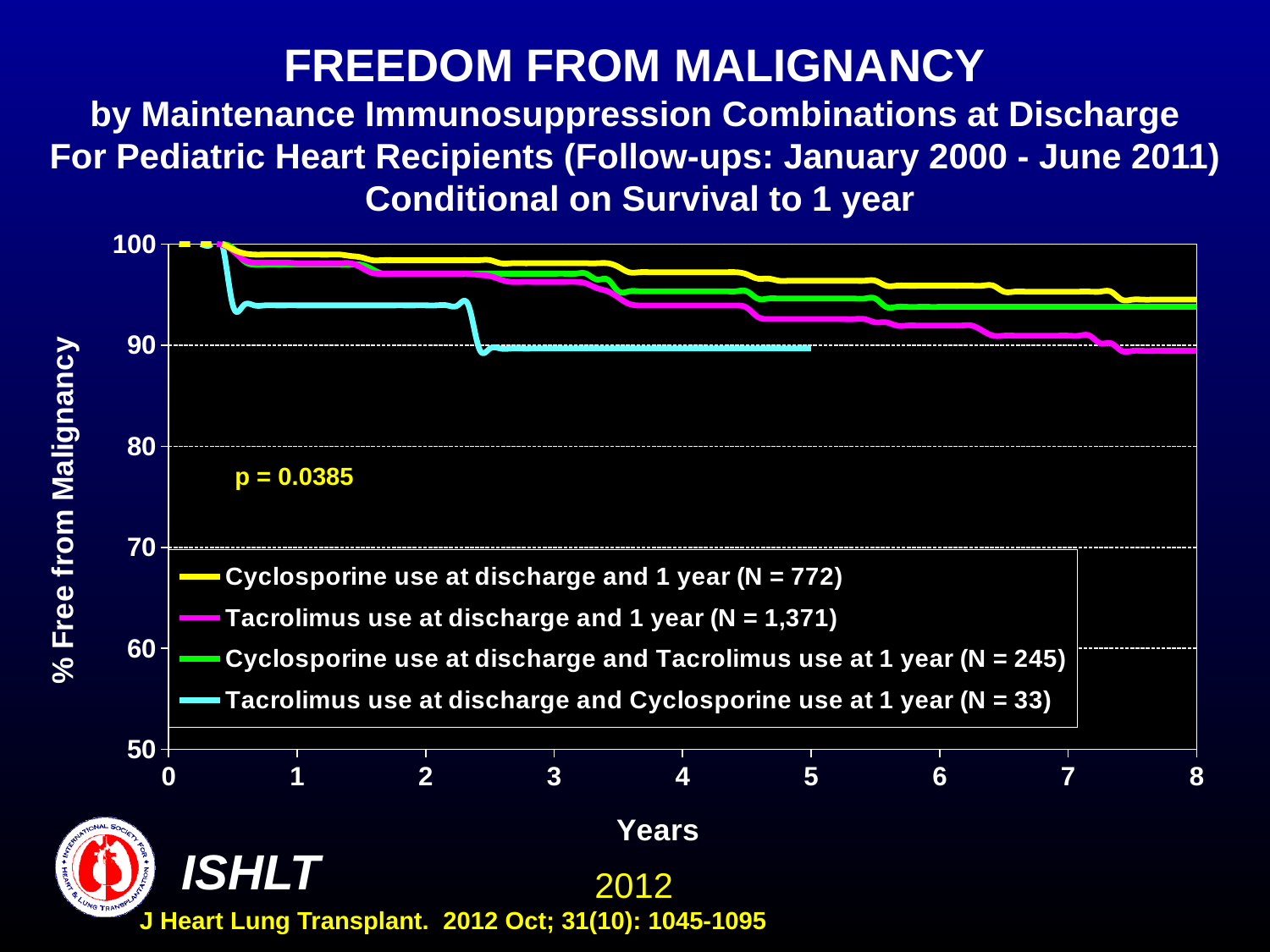
What p-value is printed on the chart? p = 0.0385 Do the lines generally rise or fall as years increase? Fall At 8 years, which is higher: the 'Cyclosporine use at discharge and 1 year' line or the 'Tacrolimus use at discharge and 1 year' line? Cyclosporine use at discharge and 1 year How many series does the legend list? 4 Which series has the highest % free from malignancy at 8 years? Cyclosporine use at discharge and 1 year (N = 772) What is the N for the 'Tacrolimus use at discharge and 1 year' series? 1,371 What is the N for the 'Cyclosporine use at discharge and 1 year' series? 772 What is the label of the y axis? % Free from Malignancy What kind of chart is shown on the slide? Line chart What is the N for the 'Tacrolimus use at discharge and Cyclosporine use at 1 year' series? 33 Which series has the lowest % free from malignancy at 5 years? Tacrolimus use at discharge and Cyclosporine use at 1 year (N = 33) Is the value for 'Tacrolimus use at discharge and 1 year' at 4 years greater or less than 90? greater